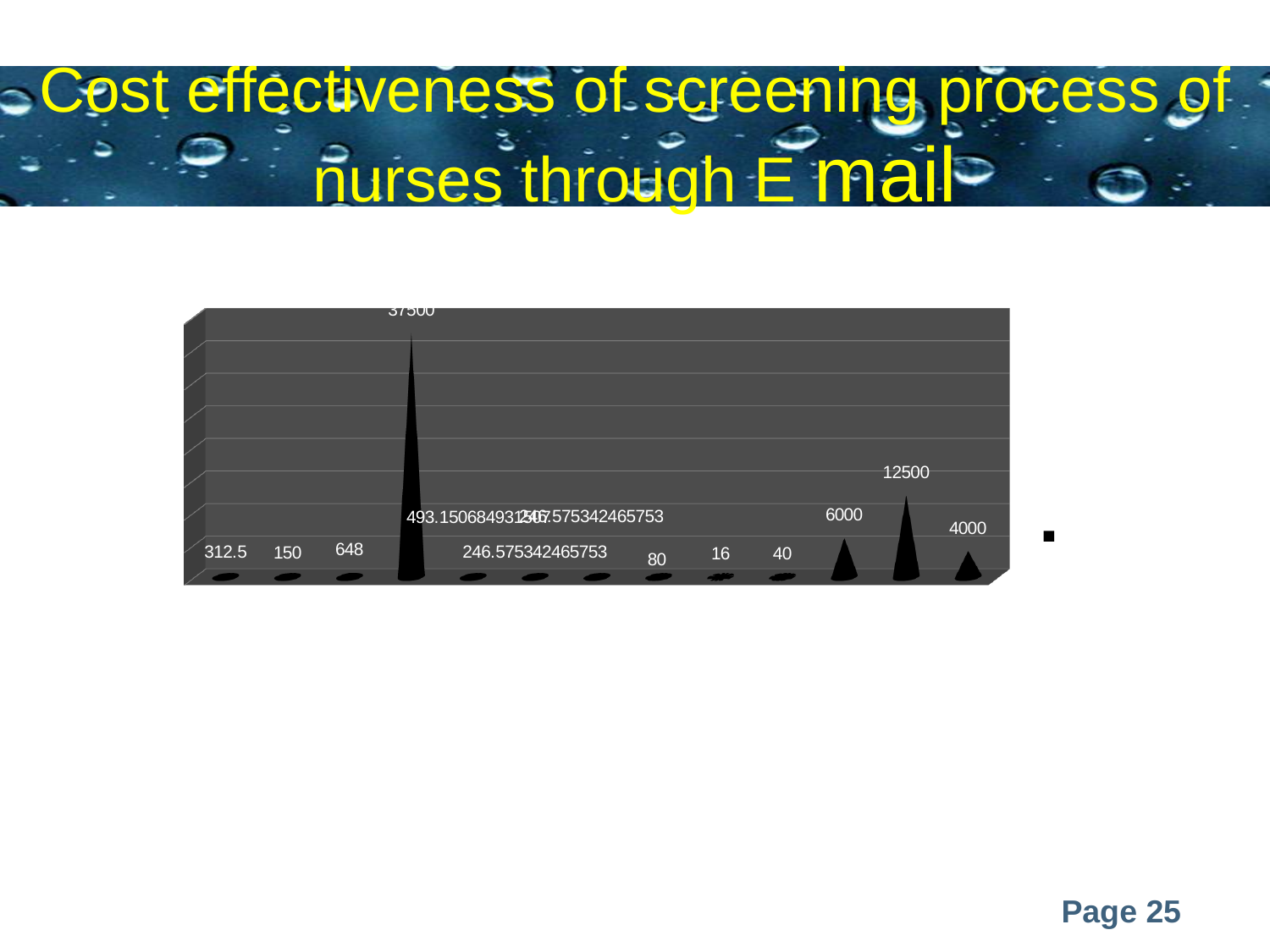
What is the title of the slide containing the chart? Cost effectiveness of screening process of nurses through E mail What is the difference between the two tallest bars, labelled 37500 and 12500? 25000 What is the difference between the bars labelled 6000 and 4000? 2000 Which is taller, the bar labelled 6000 or the bar labelled 4000? 6000 Does the chart display a legend? Yes How many bars (cones) are plotted on the chart? 13 What is the lowest value labelled on the chart? 16 What is the difference between the bars labelled 12500 and 6000? 6500 What is the value of the last (rightmost) bar on the chart? 4000 What is the highest value labelled on the chart? 37500 What is the second-highest value labelled on the chart? 12500 What is the value of the first (leftmost) bar on the chart? 312.5